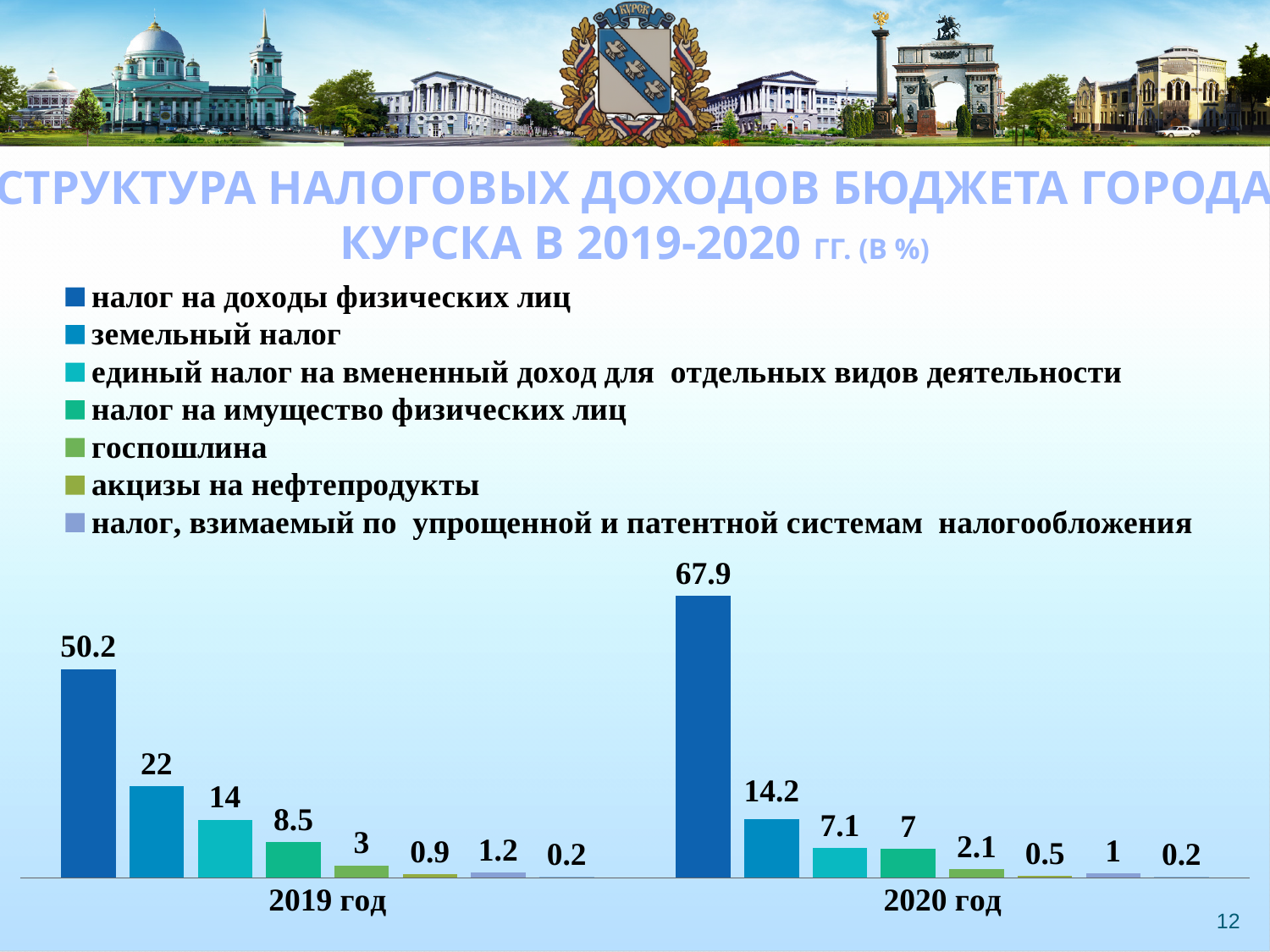
What is the difference between the земельный налог values for 2019 год and 2020 год? 7.8 What is the share of налог на доходы физических лиц in 2019 год? 50.2 Which year has the larger value for земельный налог, 2019 год or 2020 год? 2019 год Which tax has the highest share in 2020 год? налог на доходы физических лиц By how much did the share of налог на доходы физических лиц increase from 2019 год to 2020 год? 17.7 What is the value for налог на имущество физических лиц in 2020 год? 7 What is the value for единый налог на вмененный доход для отдельных видов деятельности in 2019 год? 14 How many series does the legend list? 7 What is the share of налог на доходы физических лиц in 2020 год? 67.9 What kind of chart is shown on the slide? bar chart Does the share of налог на доходы физических лиц rise or fall from 2019 год to 2020 год? rise What is the value for земельный налог in 2020 год? 14.2